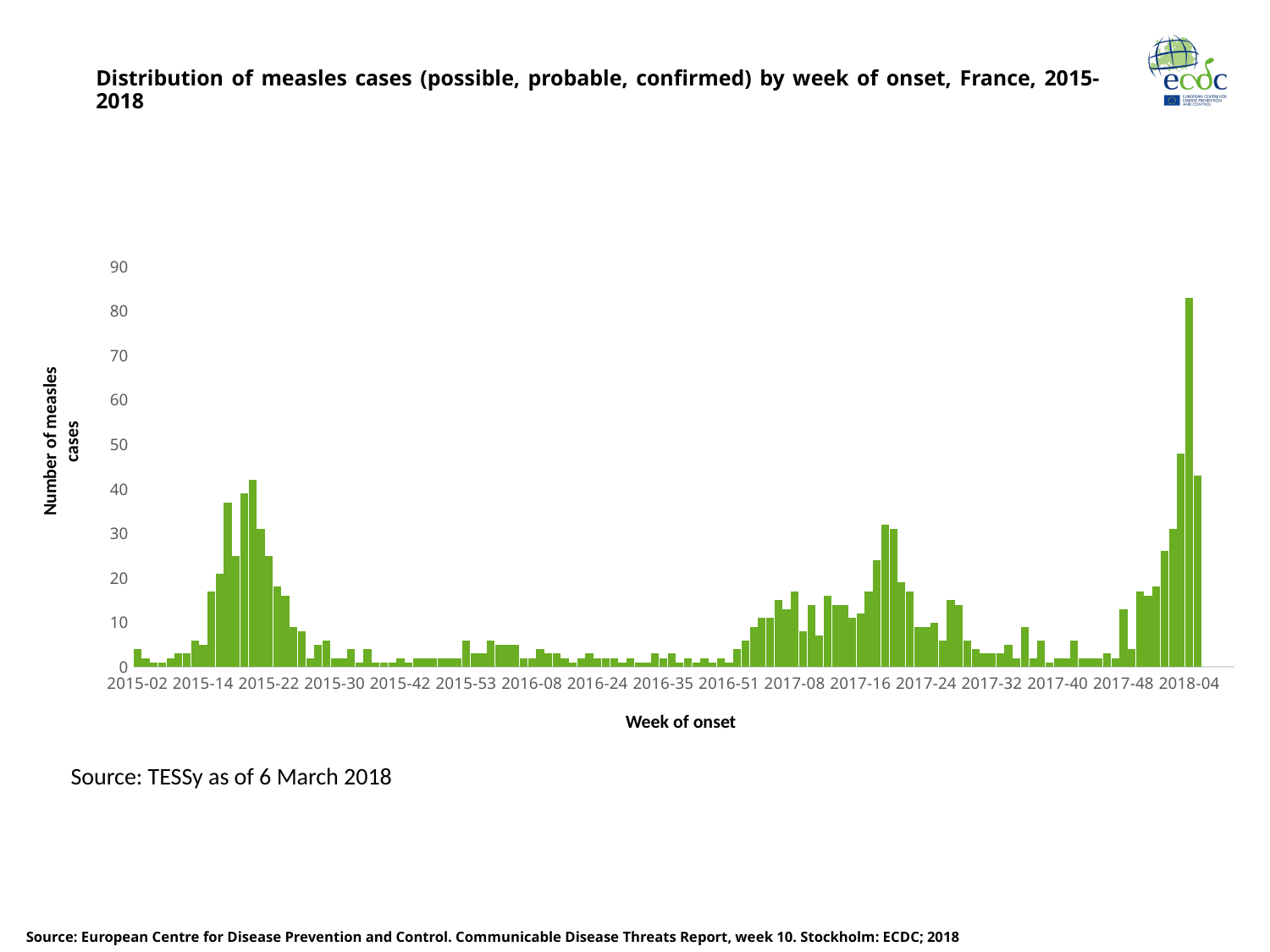
How many week labels are printed along the x axis? 17 What kind of chart is shown on the slide? Bar chart What is the label of the vertical axis? Number of measles cases Is the value for week 2016-24 greater or less than 10? less Which is larger: the peak number of cases in spring 2015 or the peak number of cases in spring 2017? spring 2015 Do the values rise or fall from week 2017-40 to week 2018-04? rise What is the title of the chart? Distribution of measles cases (possible, probable, confirmed) by week of onset, France, 2015-2018 Is the value for week 2015-02 greater or less than 10? less In which year does the tallest bar of the chart occur? 2018 Which is larger: the peak number of cases in 2015 or the peak number of cases in 2018? 2018 Is the value for week 2015-14 greater or less than 20? less